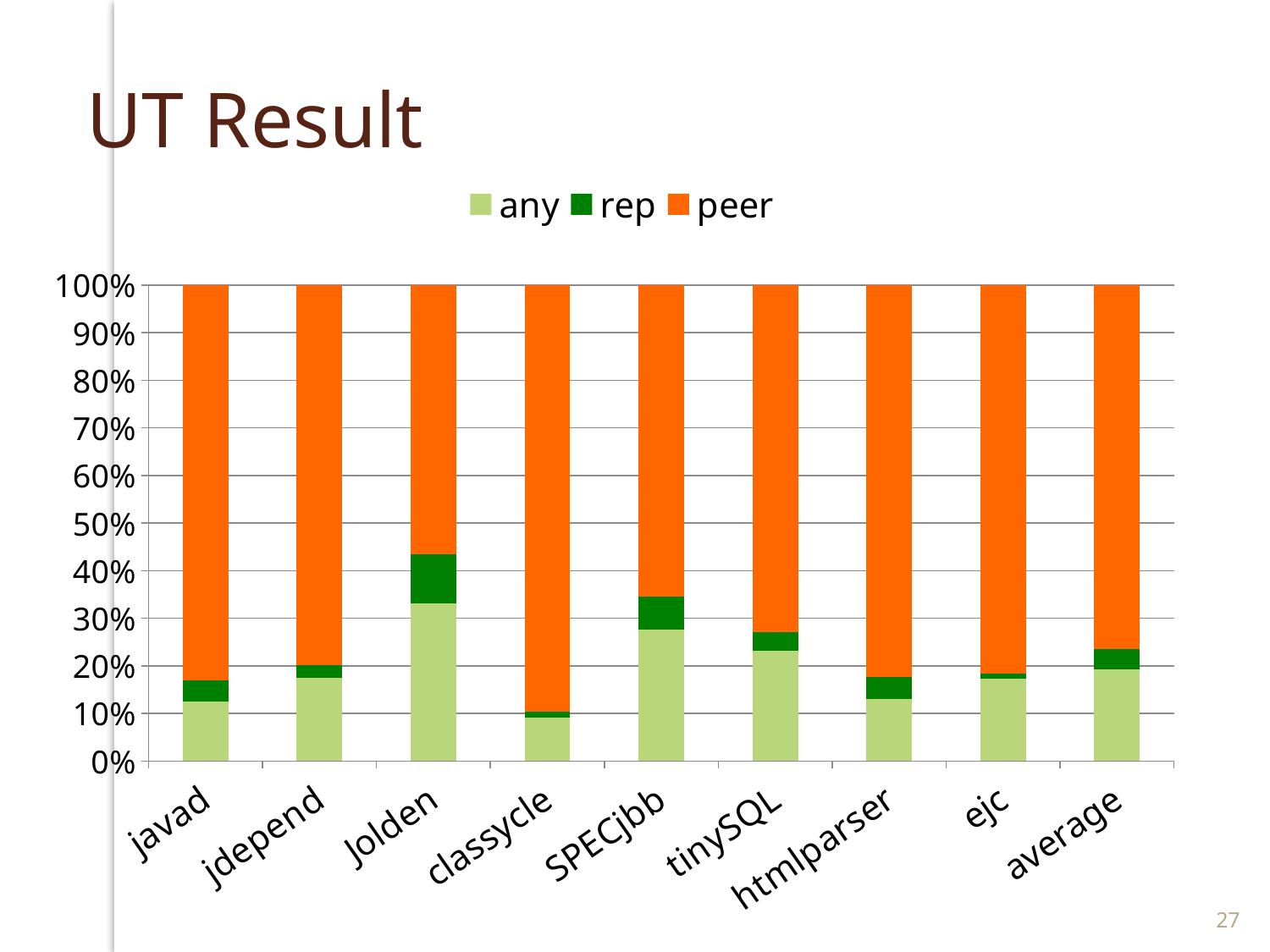
Which series is shown in orange? peer Which category has the largest 'peer' share? classycle Which category has the smallest 'any' share? classycle How many categories are shown along the x axis? 9 What kind of chart is shown on the slide? stacked bar chart Is the 'any' share for Jolden greater or less than 30%? greater What is the title of the chart? UT Result Is the 'any' share for classycle greater or less than 10%? less Which has the larger 'any' share, Jolden or SPECjbb? Jolden What is the total of the stacked bar for javad? 100% Which category has the largest 'any' share? Jolden How many series does the legend list? 3